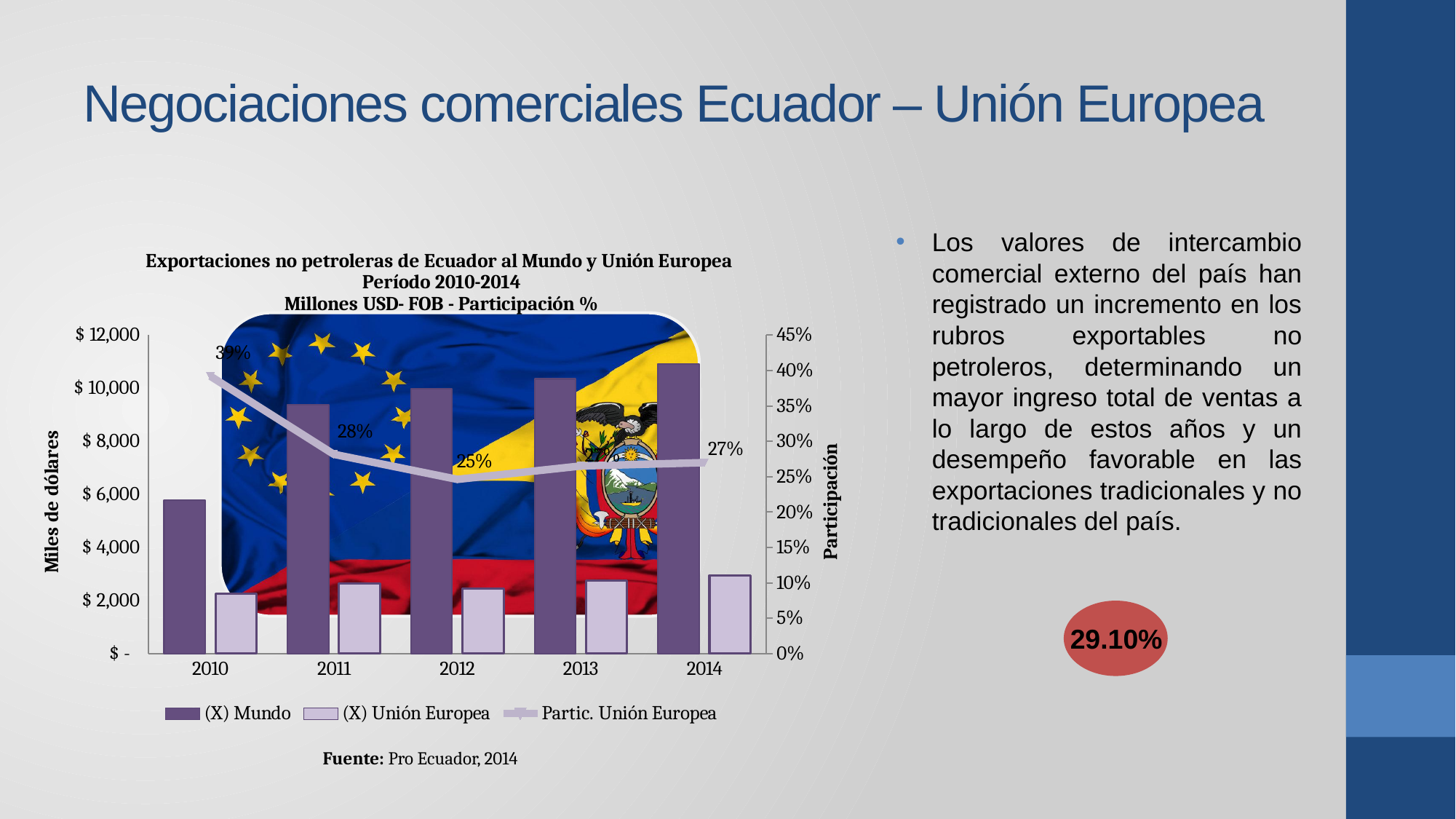
What is the value of Partic. Unión Europea for 2014? 27% Is the (X) Mundo value for 2014 greater or less than $ 10,000? greater Does Partic. Unión Europea rise or fall from 2010 to 2012? fall What is the value of Partic. Unión Europea for 2012? 25% How many years are shown on the x axis? 5 What is the difference between Partic. Unión Europea in 2010 and in 2011? 11 percentage points Which is larger, the (X) Mundo value for 2010 or for 2014? 2014 How many series does the legend list? 3 What is the value of Partic. Unión Europea for 2010? 39% In which year is Partic. Unión Europea highest? 2010 In which year is Partic. Unión Europea lowest? 2012 Is the (X) Unión Europea value for 2014 greater or less than $ 4,000? less